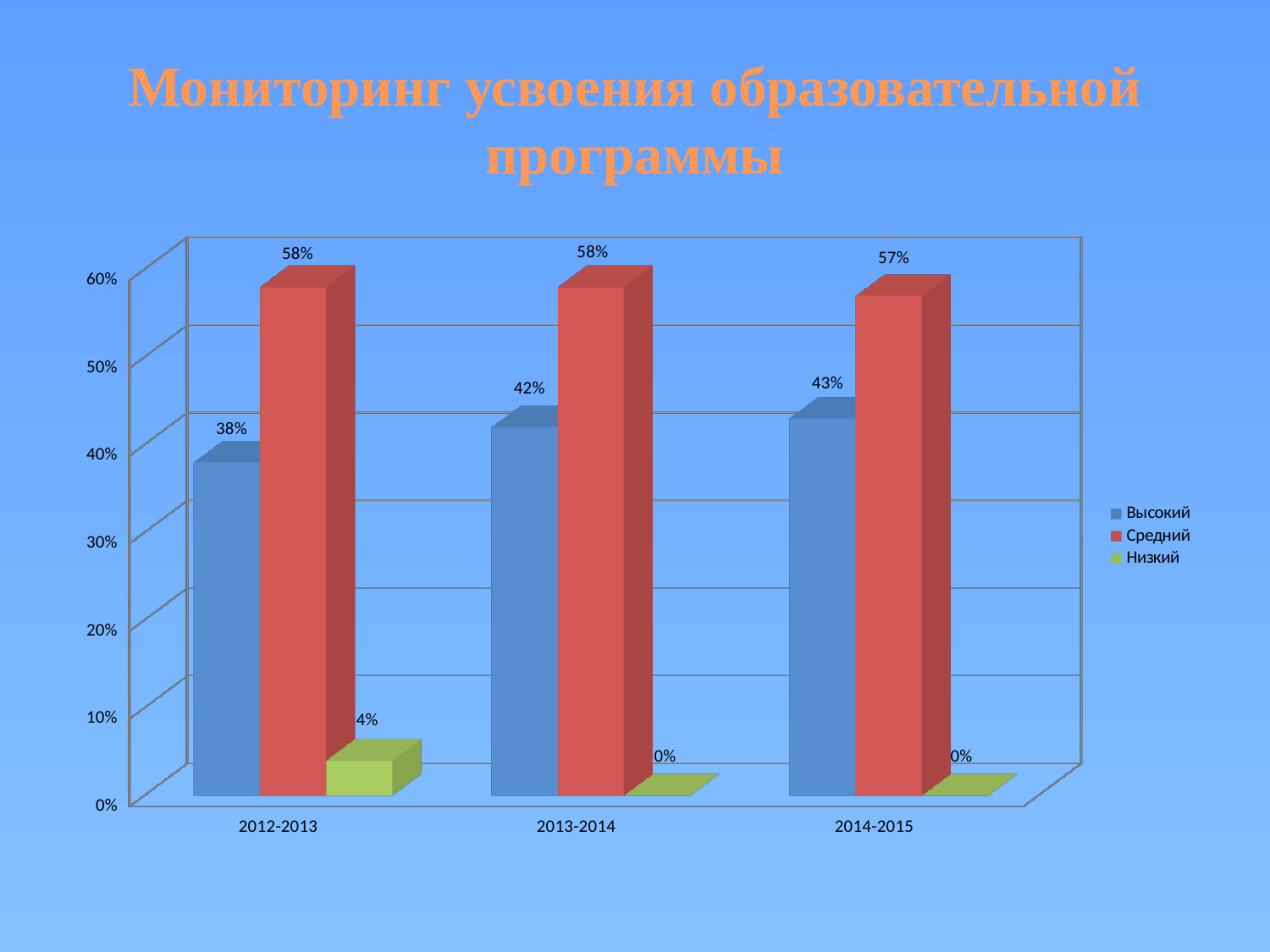
What is the value for Высокий in 2013-2014? 42% In which year is the Высокий value lowest? 2012-2013 What is the value for Низкий in 2012-2013? 4% What kind of chart is shown on the slide? Bar chart What is the value for Высокий in 2012-2013? 38% Which is larger in 2014-2015, Высокий or Средний? Средний How many year categories are shown on the x axis? 3 What is the value for Средний in 2014-2015? 57% How many series does the legend list? 3 In which year is the Высокий value highest? 2014-2015 What is the difference between the Средний and Высокий values in 2012-2013? 20% Does the Высокий value rise or fall from 2012-2013 to 2014-2015? Rise